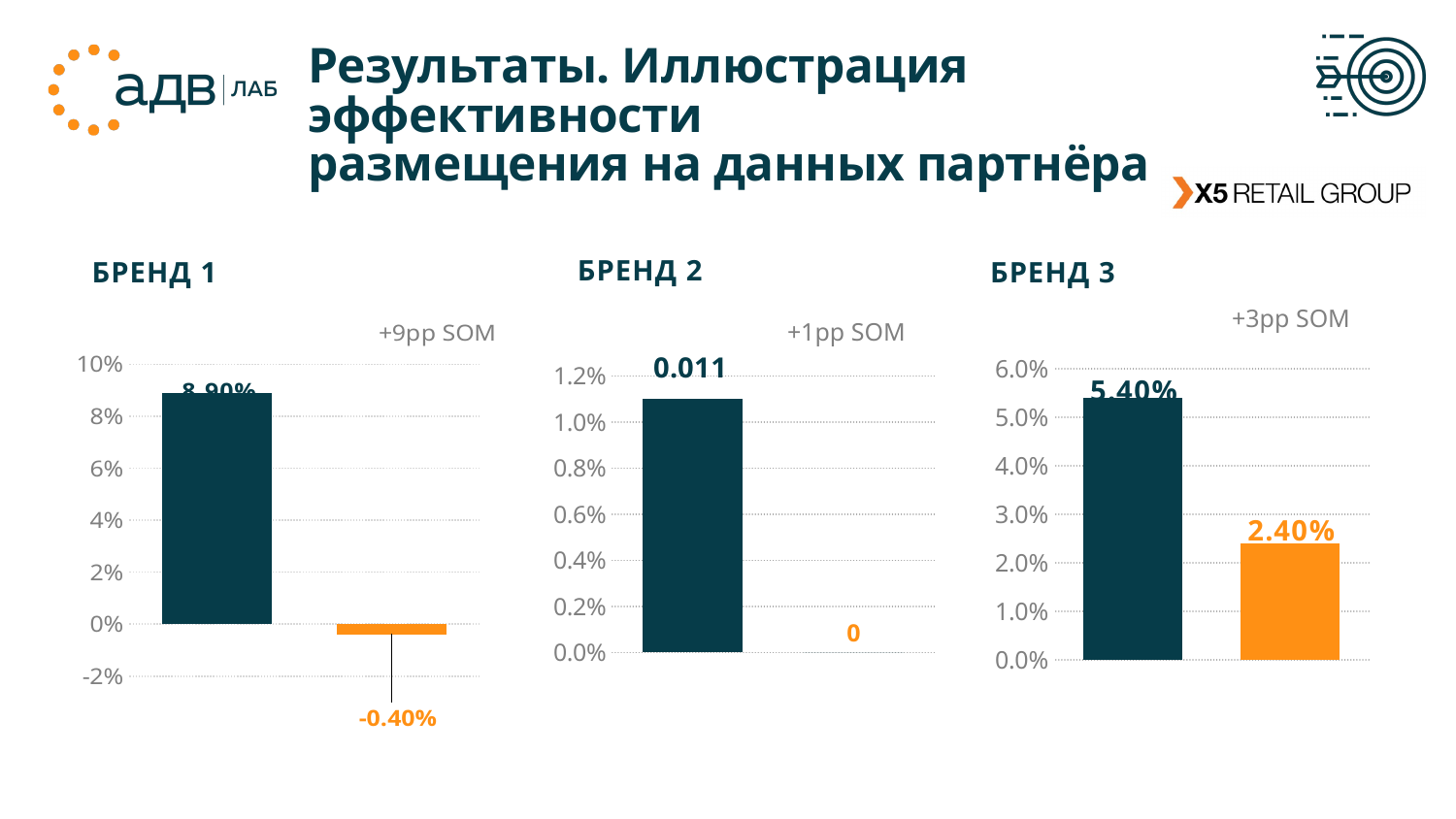
In the БРЕНД 1 chart, what is the value shown on the dark bar? 8.90% How many bars are plotted in the БРЕНД 2 chart? 2 What SOM change annotation is shown above the БРЕНД 1 chart? +9pp SOM In the БРЕНД 2 chart, what is the data label on the second (orange) bar? 0 In the БРЕНД 1 chart, what is the value shown on the orange bar? -0.40% What type of chart is used for БРЕНД 3? bar chart In the БРЕНД 3 chart, which bar is higher, the dark bar or the orange bar? the dark bar In the БРЕНД 3 chart, what is the value of the orange bar? 2.40% In the БРЕНД 3 chart, what is the value of the dark bar? 5.40% In the БРЕНД 1 chart, is the value of the dark bar greater or less than 8%? greater In the БРЕНД 3 chart, what is the difference between the dark bar and the orange bar? 3.00% In the БРЕНД 2 chart, what is the data label on the dark bar? 0.011